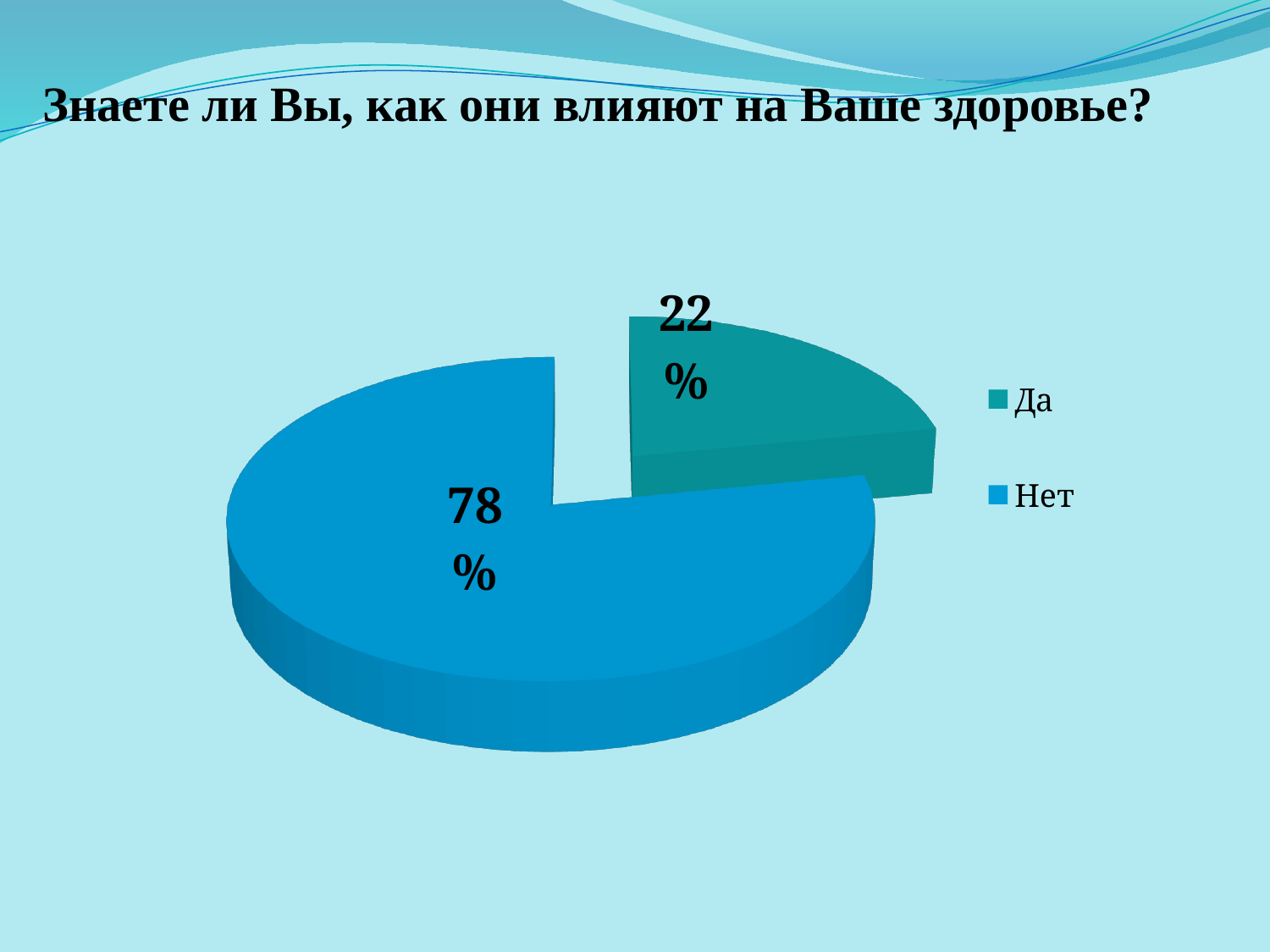
What share of the pie does the "Нет" slice represent? 78% What is the title of the slide above the chart? Знаете ли Вы, как они влияют на Ваше здоровье? What percentage is shown for the "Да" slice? 22% How many slices does the pie chart have? 2 How many entries does the legend list? 2 What type of chart is shown on the slide? pie chart What is the difference in percentage points between the "Нет" and "Да" slices? 56 Which category has the smallest share of the pie? Да Which is larger, the "Да" slice or the "Нет" slice? Нет Which legend entry is shown in the darker teal-green colour? Да What percentage is shown for the "Нет" slice? 78% Which category has the largest share of the pie? Нет